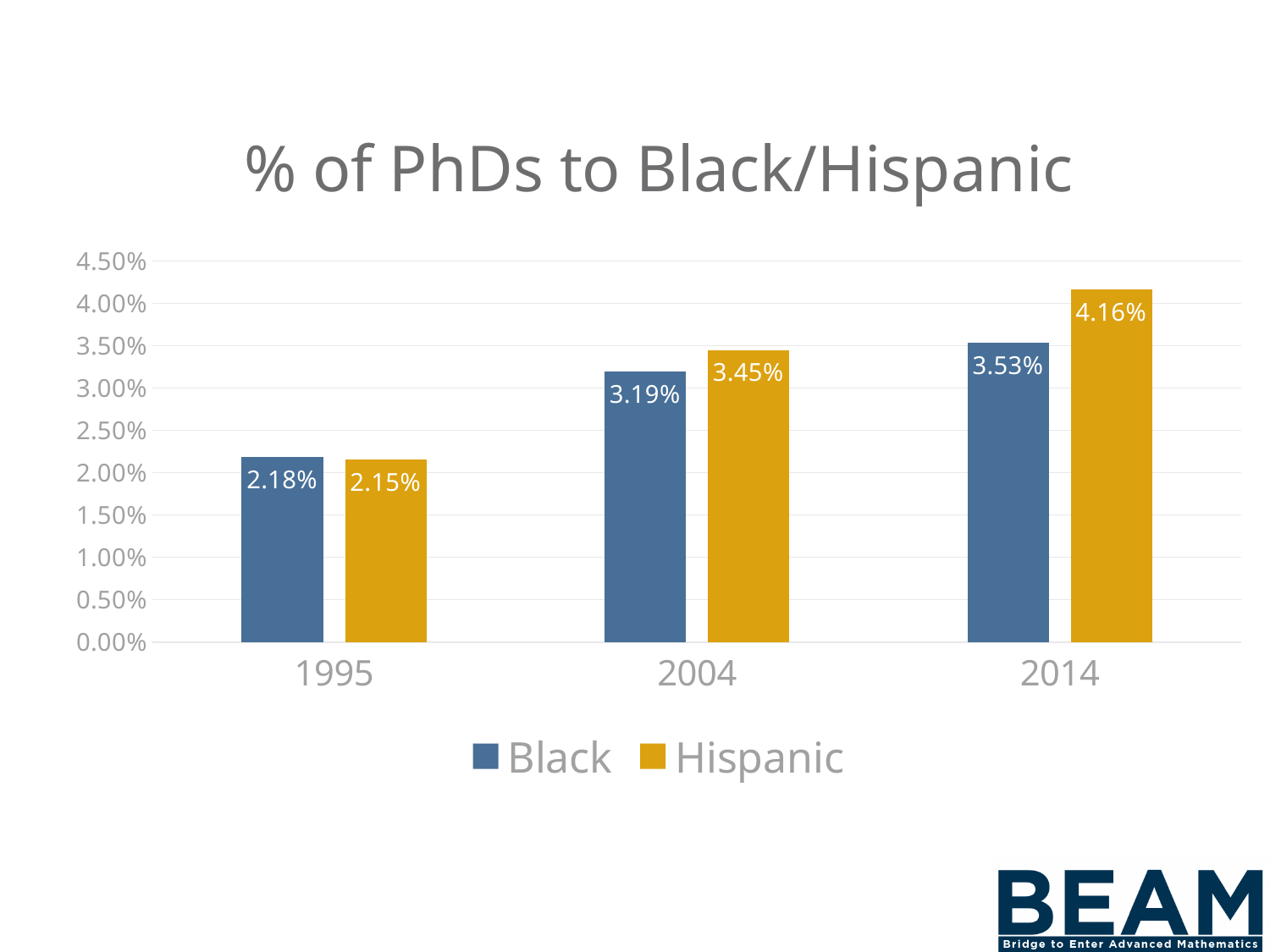
Do the Black values rise or fall from 1995 to 2014? Rise Which is larger in 2004, the Black value or the Hispanic value? Hispanic How many years are shown on the x axis? 3 What kind of chart is shown? Bar chart In which year is the Black value lowest? 1995 What is the value for Black in 1995? 2.18% What is the value for Hispanic in 2014? 4.16% In which year is the Hispanic value highest? 2014 What is the difference between the Hispanic and Black values in 2014? 0.63% How many series does the legend list? 2 What is the value for Black in 2014? 3.53% What is the value for Hispanic in 2004? 3.45%